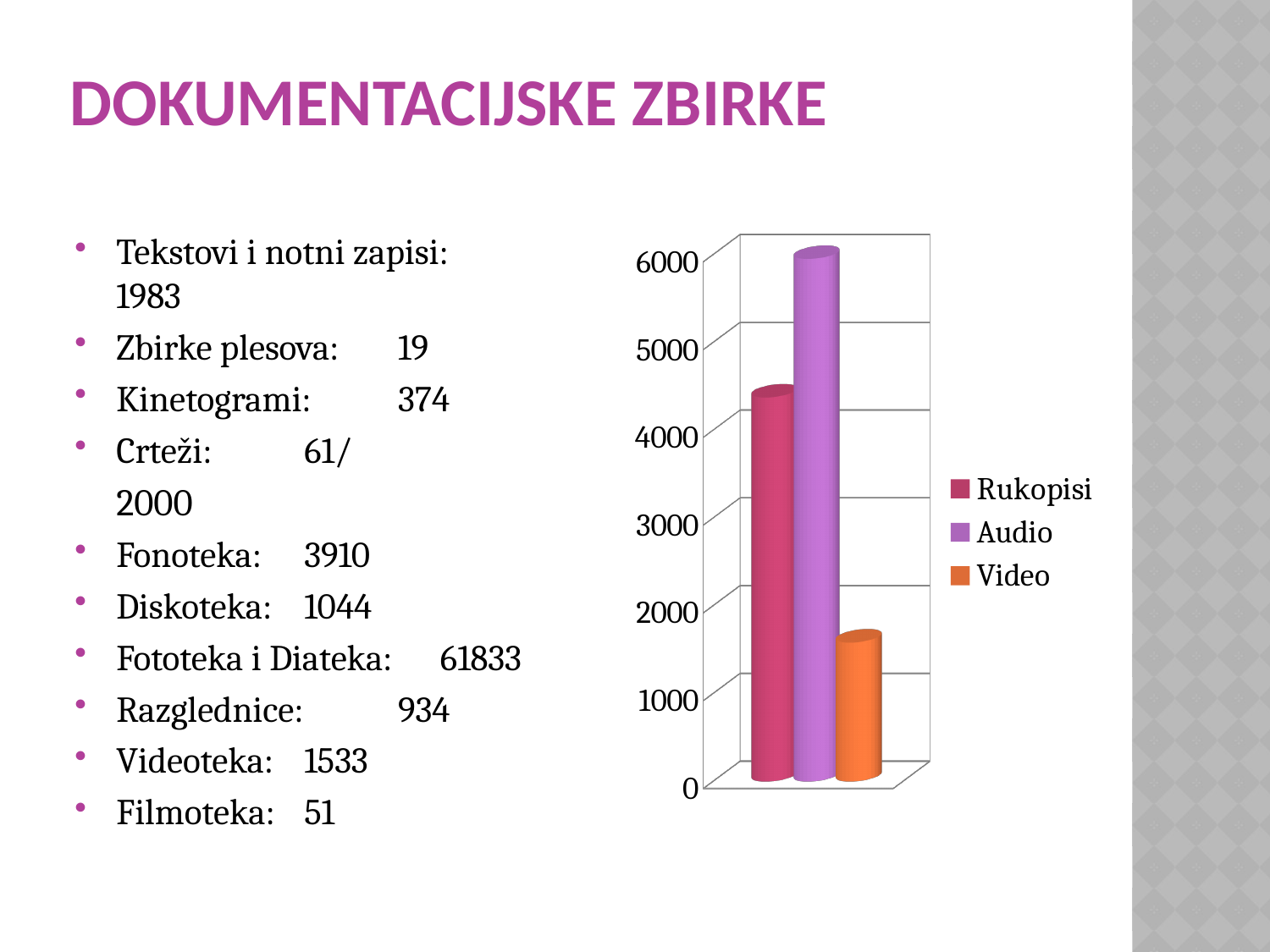
Is the value for Audio greater or less than 5000? greater Which series has the lowest bar in the chart? Video Is the value for Video greater or less than 2000? less Which series has the highest bar in the chart? Audio Is the value for Rukopisi greater or less than 4000? greater What colour is the Audio bar in the chart? purple What kind of chart is shown on the slide? bar chart Which is larger in the chart, Rukopisi or Video? Rukopisi Which is larger in the chart, Audio or Rukopisi? Audio What is the highest value shown on the chart's vertical axis? 6000 How many series does the chart legend list? 3 How many bars are plotted in the chart? 3